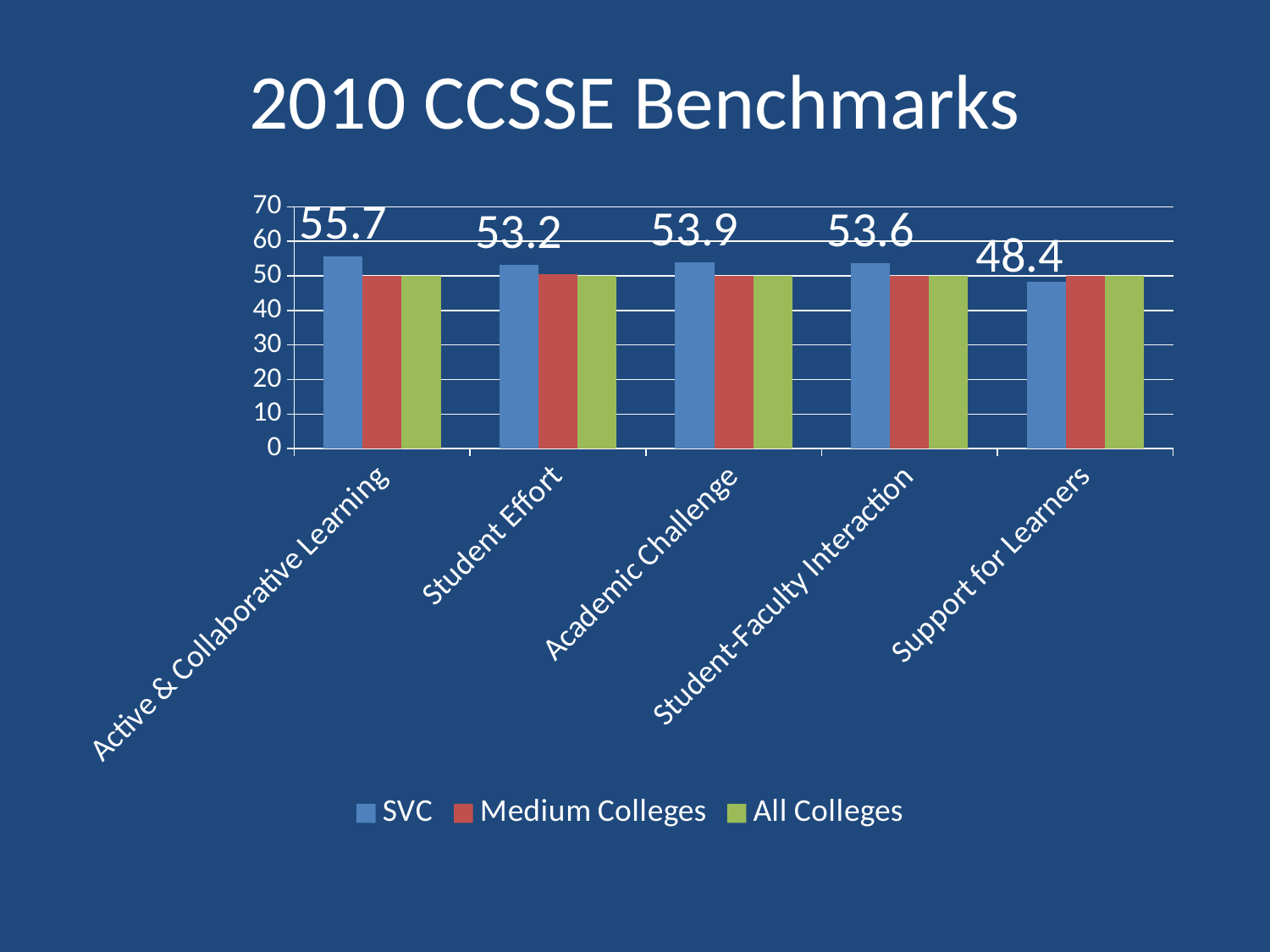
Which benchmark has the highest SVC value? Active & Collaborative Learning What is the SVC value for Student-Faculty Interaction? 53.6 Which benchmark has the lowest SVC value? Support for Learners Which is larger for SVC: Academic Challenge or Student Effort? Academic Challenge What is the difference between the SVC values for Active & Collaborative Learning and Support for Learners? 7.3 Is the Medium Colleges value for Student Effort greater or less than 40? greater For Active & Collaborative Learning, which is larger: the SVC bar or the Medium Colleges bar? SVC How many series does the legend list? 3 What kind of chart is shown on the slide? bar chart What is the SVC value for Support for Learners? 48.4 What is the SVC value for Active & Collaborative Learning? 55.7 How many benchmark categories are shown on the x axis? 5